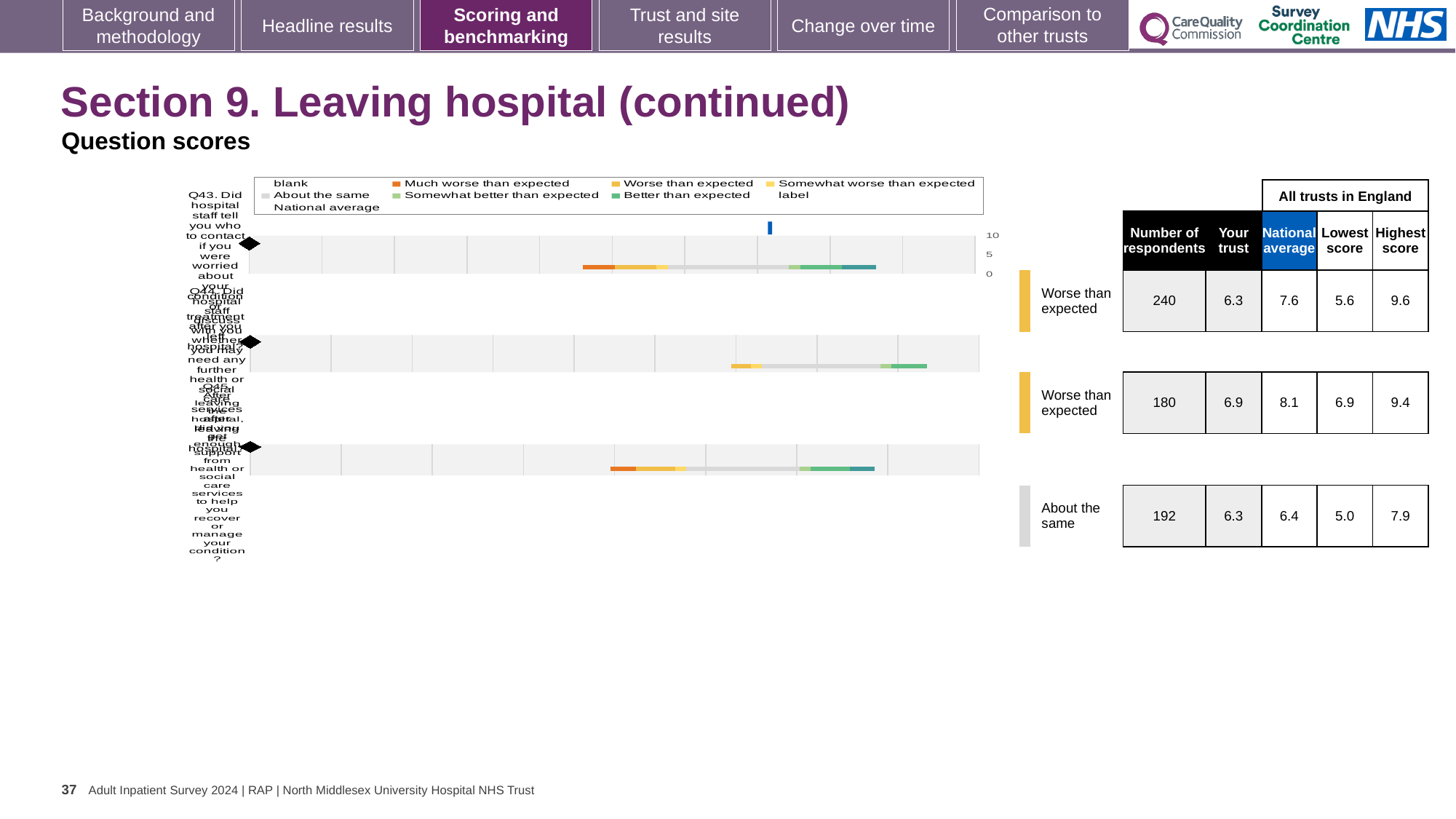
Which question row has the lowest national average? Q45 Which question row has the highest number of respondents? Q43 What kind of chart is used to show the question scores on this slide? bar chart What colour represents 'Much worse than expected' in the chart legend? orange How many questions (rows) are plotted in the question scores chart? 3 In the table beside the chart, what is the 'Your trust' score for Q43 (the first row)? 6.3 For Q44 (the second row), what is the difference between the national average and the 'Your trust' score? 1.2 Which has the higher 'Highest score' value: Q43 (first row) or Q44 (second row)? Q43 In the table beside the chart, how many respondents are listed for Q45 (the third row)? 192 In the table beside the chart, what is the national average for Q44 (the second row)? 8.1 What benchmark category is shown for Q45 (the third row)? About the same In the table beside the chart, what is the lowest score across all trusts in England for Q43 (the first row)? 5.6